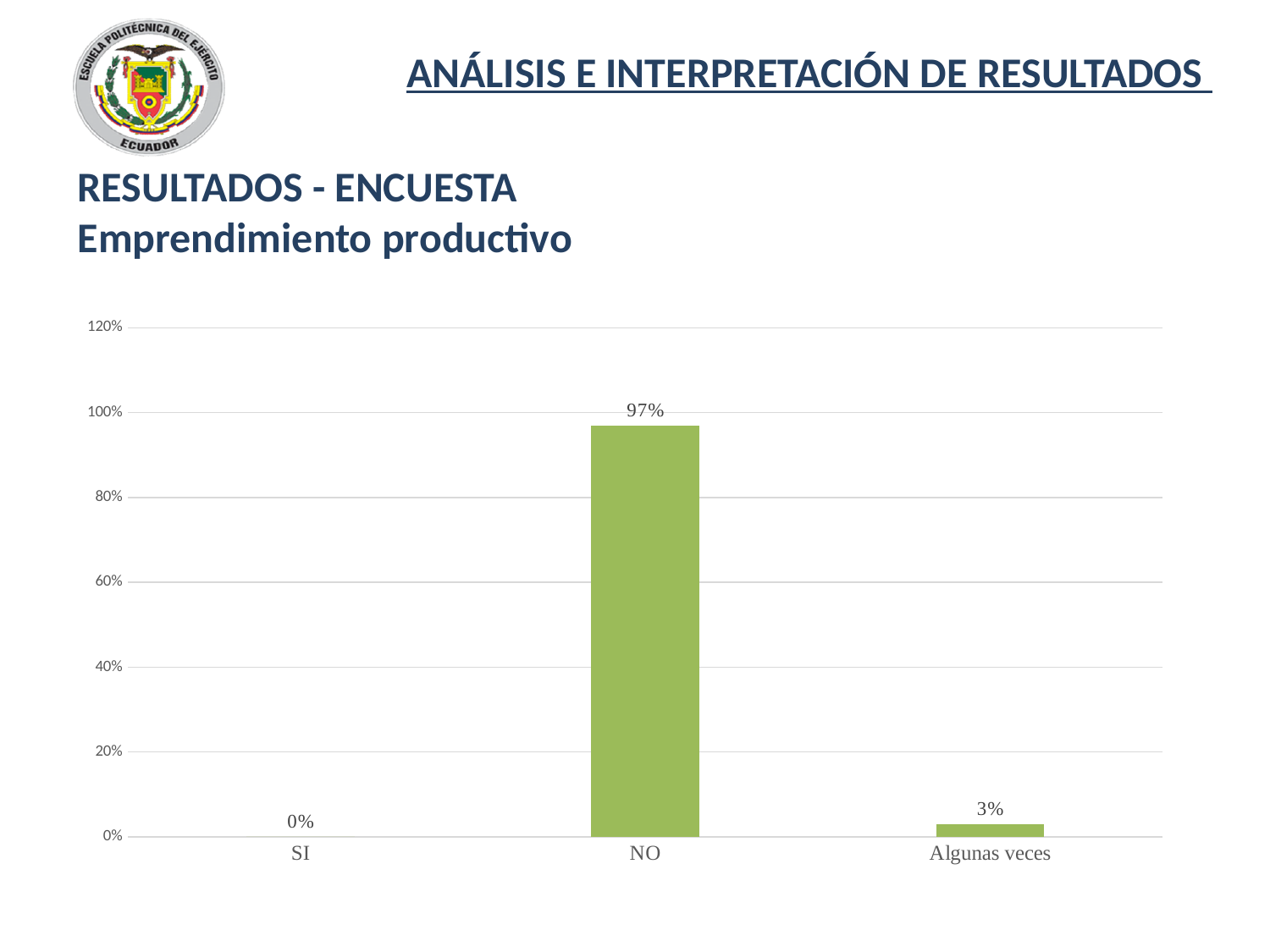
Which category has the highest value? NO How many categories are shown on the x axis? 3 What is the difference between the values for NO and Algunas veces? 94% What is the value for SI? 0% What is the highest tick value shown on the y axis? 120% What is the value for Algunas veces? 3% What is the value for NO? 97% Which category has the lowest value? SI Is the value for NO greater or less than 80%? greater Which is larger, the value for Algunas veces or the value for SI? Algunas veces What kind of chart is shown on the slide? bar chart What colour are the bars in the chart? green